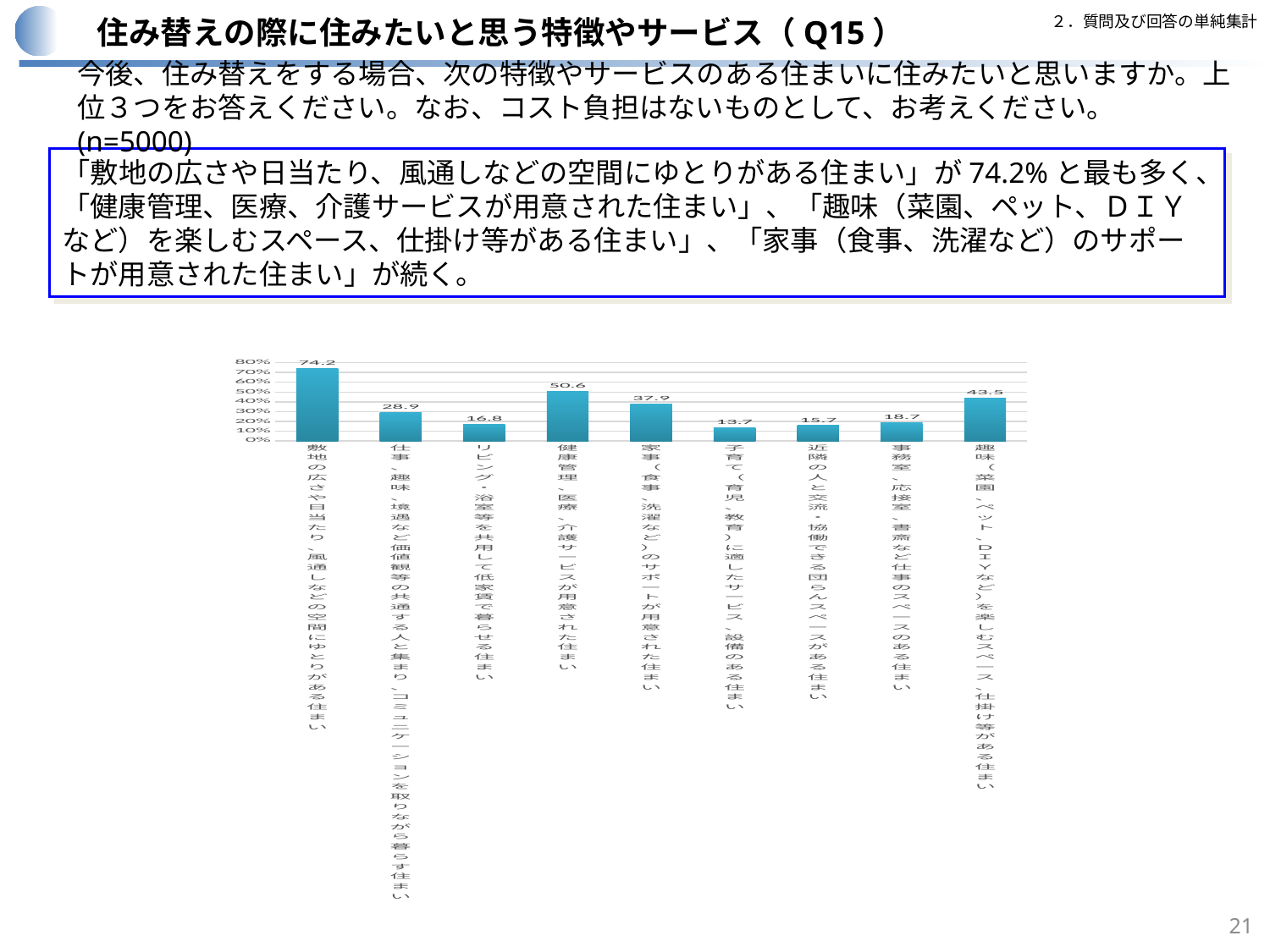
What is the value for 「健康管理、医療、介護サービスが用意された住まい」? 50.6 Which category has the highest value? 敷地の広さや日当たり、風通しなどの空間にゆとりがある住まい What is the difference between the values for 「健康管理、医療、介護サービスが用意された住まい」 and 「家事（食事、洗濯など）のサポートが用意された住まい」? 12.7 What is the value for 「趣味（菜園、ペット、ＤＩＹなど）を楽しむスペース、仕掛け等がある住まい」? 43.5 Is the value for 「リビング・浴室等を共用して低家賃で暮らせる住まい」 greater or less than 20%? less What is the maximum value shown on the vertical axis? 80% What is the value for 「子育て（育児、教育）に適したサービス、設備のある住まい」? 13.7 What is the value for 「敷地の広さや日当たり、風通しなどの空間にゆとりがある住まい」? 74.2 Which category has the lowest value? 子育て（育児、教育）に適したサービス、設備のある住まい How many categories (bars) are plotted in the chart? 9 Which is larger: the value for 「仕事、趣味、境遇など価値観等の共通する人と集まり、コミュニケーションを取りながら暮らす住まい」 or 「事務室、応接室、書斎など仕事のスペースのある住まい」? 仕事、趣味、境遇など価値観等の共通する人と集まり、コミュニケーションを取りながら暮らす住まい What type of chart is shown on the slide? bar chart